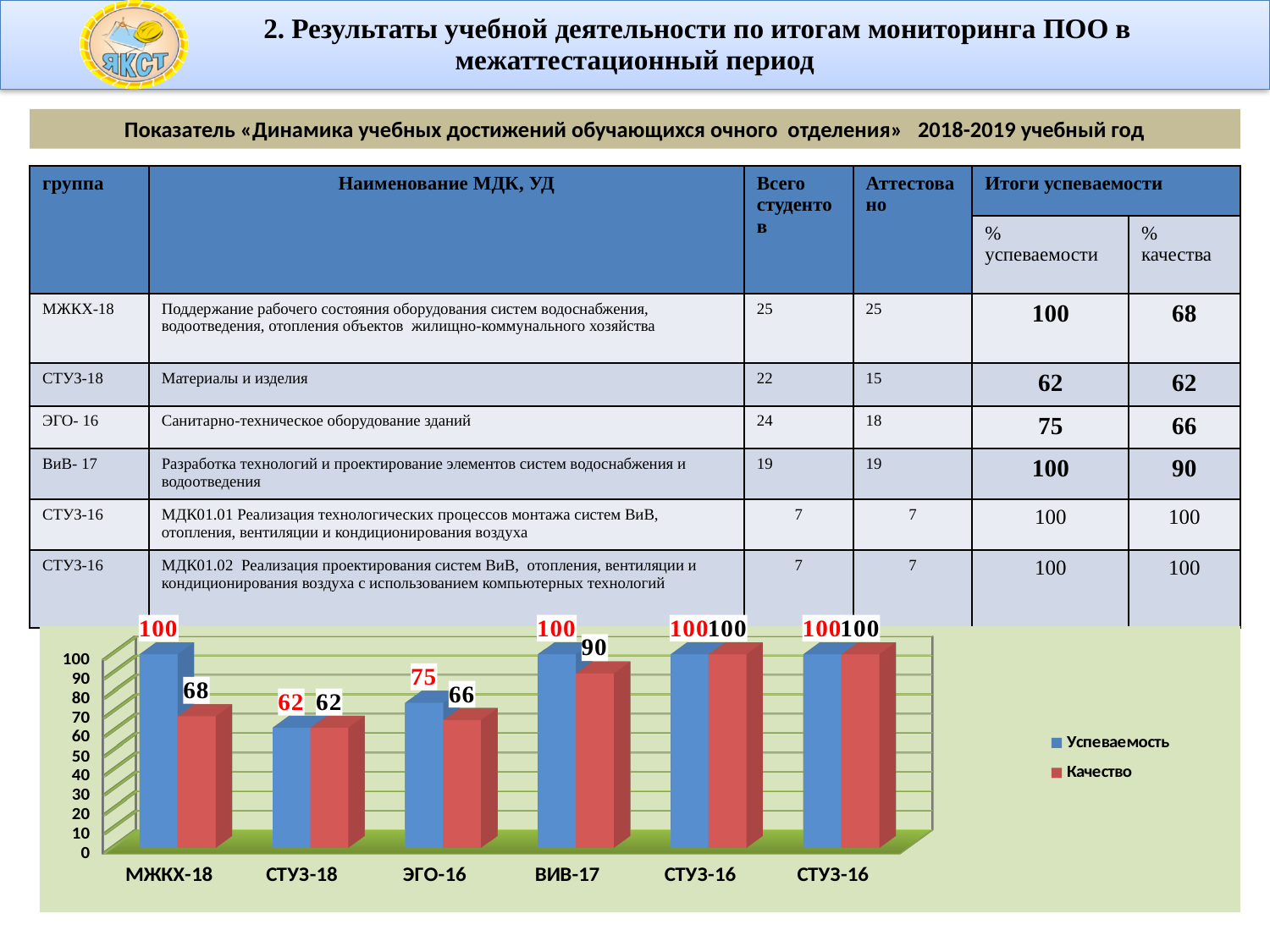
Which is larger in the chart: the Качество value for ВИВ-17 or the Качество value for ЭГО-16? ВИВ-17 How many series does the chart legend list? 2 What is the Успеваемость value for СТУЗ-18 in the chart? 62 What is the Качество value for ВИВ-17 in the chart? 90 Which series in the chart is shown in red? Качество What is the Качество value for ЭГО-16 in the chart? 66 What kind of chart is shown on the slide? bar chart How many categories are shown on the x axis of the chart? 6 What is the Успеваемость value for МЖКХ-18 in the chart? 100 What is the difference between the Успеваемость and Качество values for МЖКХ-18 in the chart? 32 Which category has the lowest Успеваемость value in the chart? СТУЗ-18 Is the Успеваемость value for ЭГО-16 in the chart greater or less than 70? greater